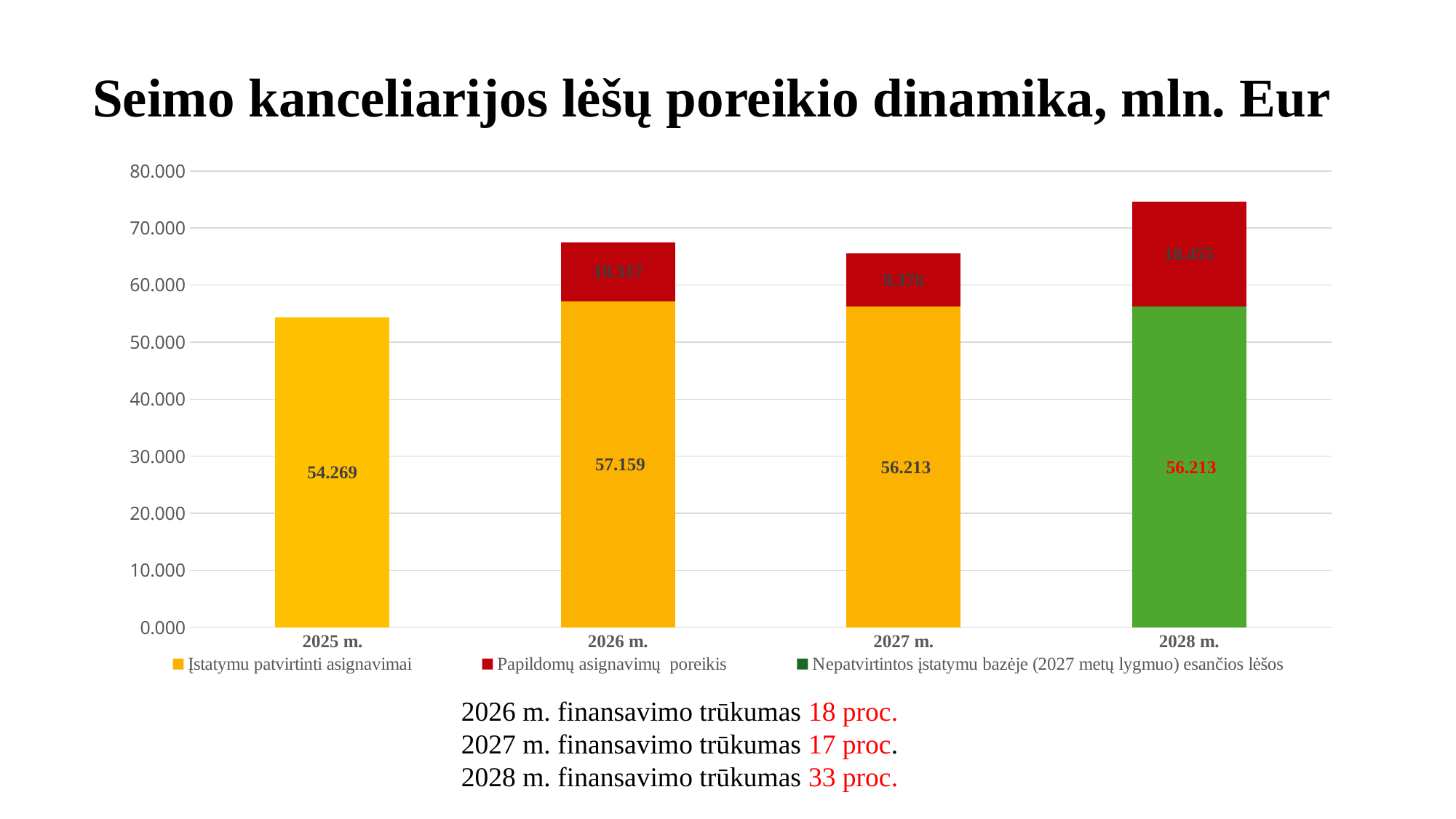
How many series does the legend list? 3 What is the difference between the Papildomų asignavimų poreikis values for 2028 m. and 2027 m.? 9.079 What is the total of the stacked bar for 2028 m.? 74.668 What is the value of Papildomų asignavimų poreikis for 2028 m.? 18.455 What is the value of Įstatymu patvirtinti asignavimai for 2026 m.? 57.159 What is the value of Įstatymu patvirtinti asignavimai for 2025 m.? 54.269 Is the Papildomų asignavimų poreikis value larger for 2026 m. or 2027 m.? 2026 m. What kind of chart is shown on the slide? Stacked bar chart Which year has the lowest total stacked bar? 2025 m. What is the total of the stacked bar for 2026 m.? 67.476 Which year has the highest total stacked bar? 2028 m. What is the value of Papildomų asignavimų poreikis for 2027 m.? 9.376